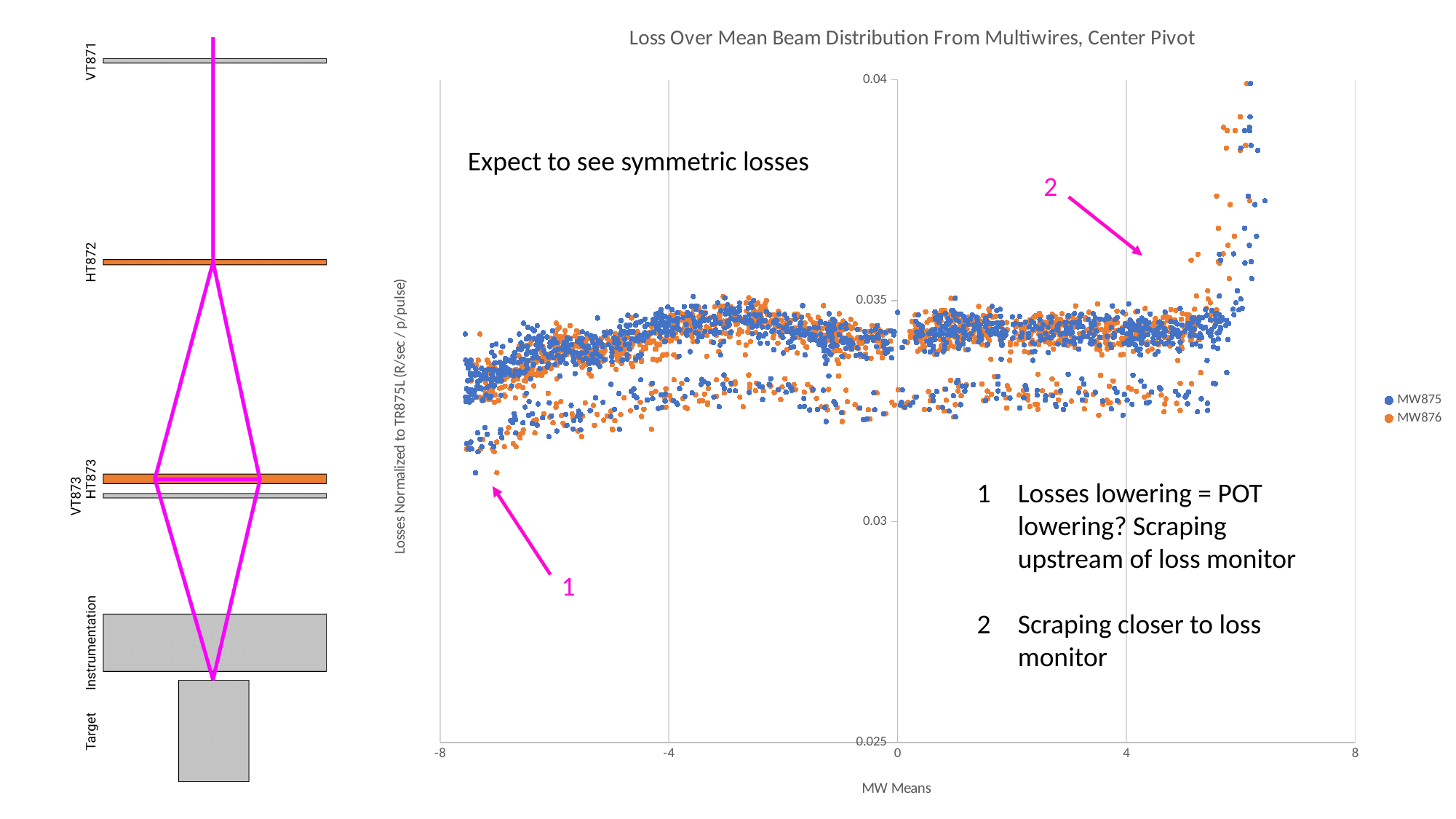
What kind of chart is shown on the slide? scatter chart What is the label of the x axis of the chart? MW Means Are the lowest points near MW Means of -7.5 greater or less than 0.035? less What is the lowest value shown on the x axis of the chart? -8 How many series does the chart legend list? 2 Are the points in the main band around MW Means of 0 greater or less than 0.03? greater Which series is plotted in orange? MW876 Do the losses rise or fall as MW Means increases from -8 to -4? rise What are the names of the two series in the chart legend? MW875 and MW876 What is the title of the chart? Loss Over Mean Beam Distribution From Multiwires, Center Pivot What is the highest value shown on the y axis of the chart? 0.04 Are the highest points near MW Means of 6 greater or less than 0.035? greater